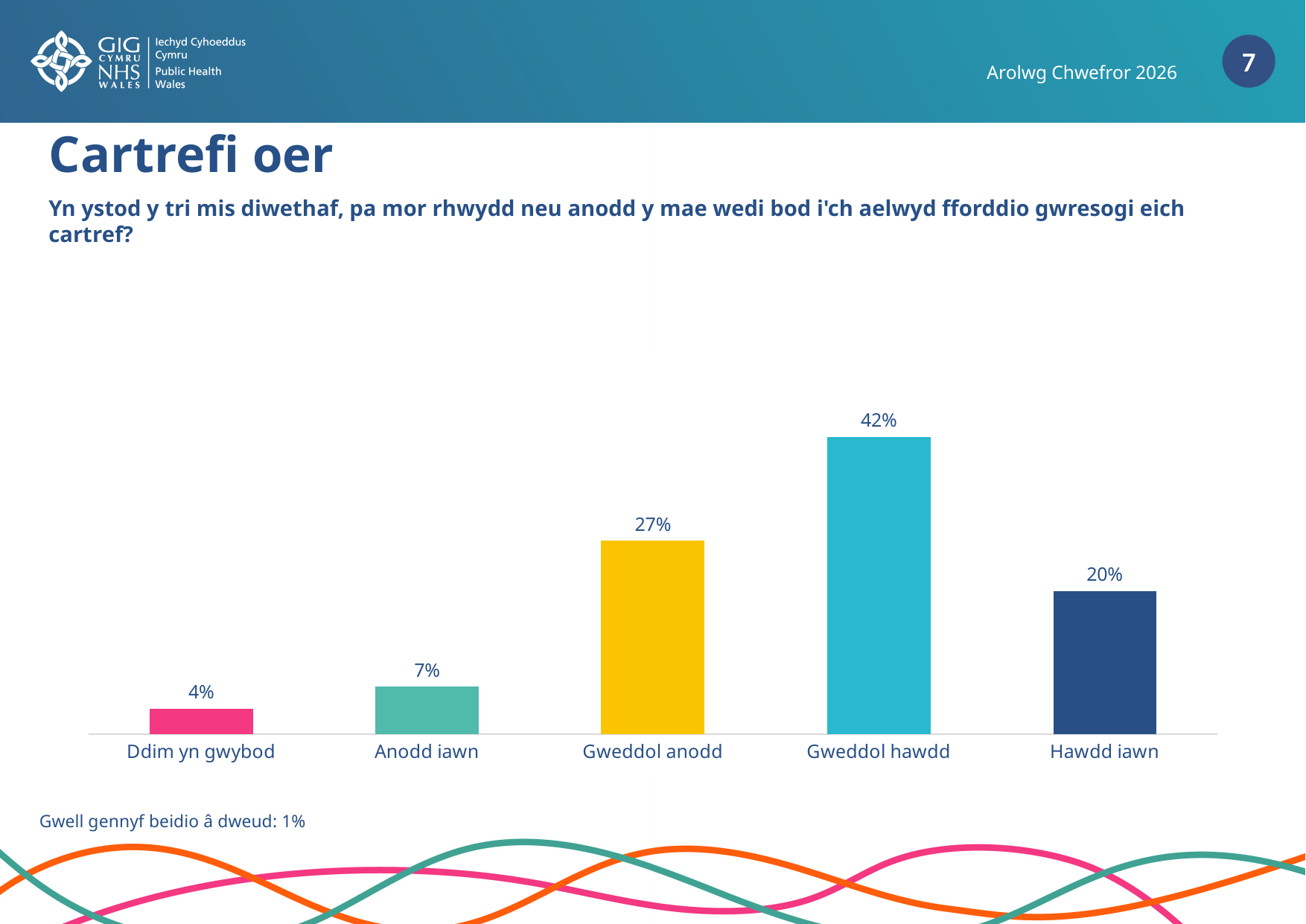
What is the value for Hawdd iawn? 20% Which is larger, the value for Gweddol anodd or the value for Hawdd iawn? Gweddol anodd Which category has the lowest value? Ddim yn gwybod What is the value for Gweddol hawdd? 42% What colour is the bar for Gweddol anodd? Yellow How many categories are shown on the chart? 5 What is the value for Ddim yn gwybod? 4% What is the value for Anodd iawn? 7% What is the difference between the values for Hawdd iawn and Anodd iawn? 13% What is the difference between the values for Gweddol hawdd and Gweddol anodd? 15% Which category has the highest value? Gweddol hawdd What kind of chart is shown on the slide? Bar chart